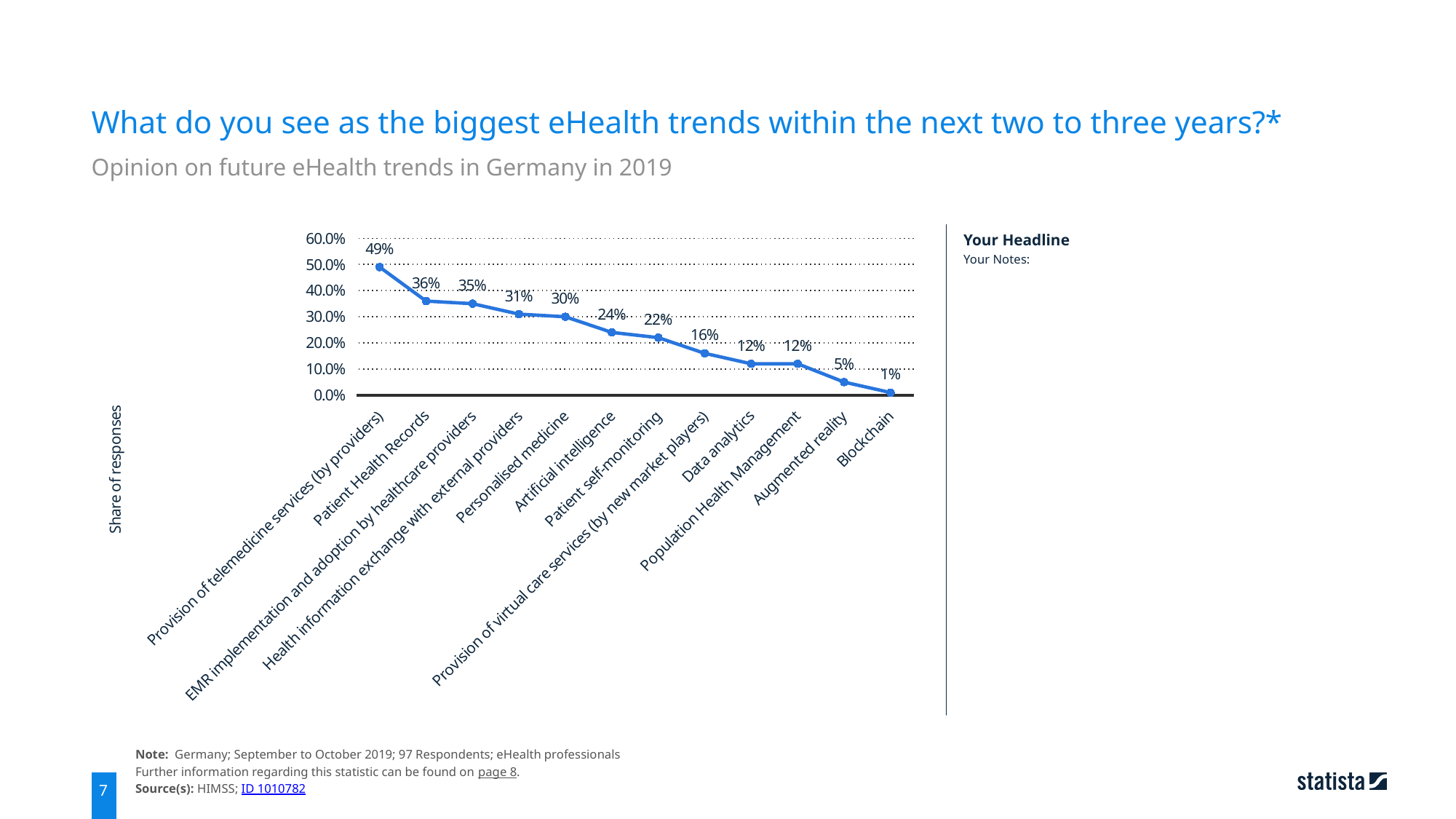
Which category has the highest share of responses? Provision of telemedicine services (by providers) What share of responses is shown for Augmented reality? 5% Which category has the lowest share of responses? Blockchain What kind of chart is shown on the slide? Line chart Is the value for EMR implementation and adoption by healthcare providers greater or less than 30.0%? greater What share of responses is shown for Artificial intelligence? 24% What share of responses is shown for Provision of telemedicine services (by providers)? 49% How many categories are plotted on the chart? 12 What is the difference between the shares for Patient Health Records and Personalised medicine? 6% Do the values rise or fall from left to right along the x axis? Fall What is the label of the vertical axis? Share of responses Which has a larger share of responses, Patient self-monitoring or Data analytics? Patient self-monitoring